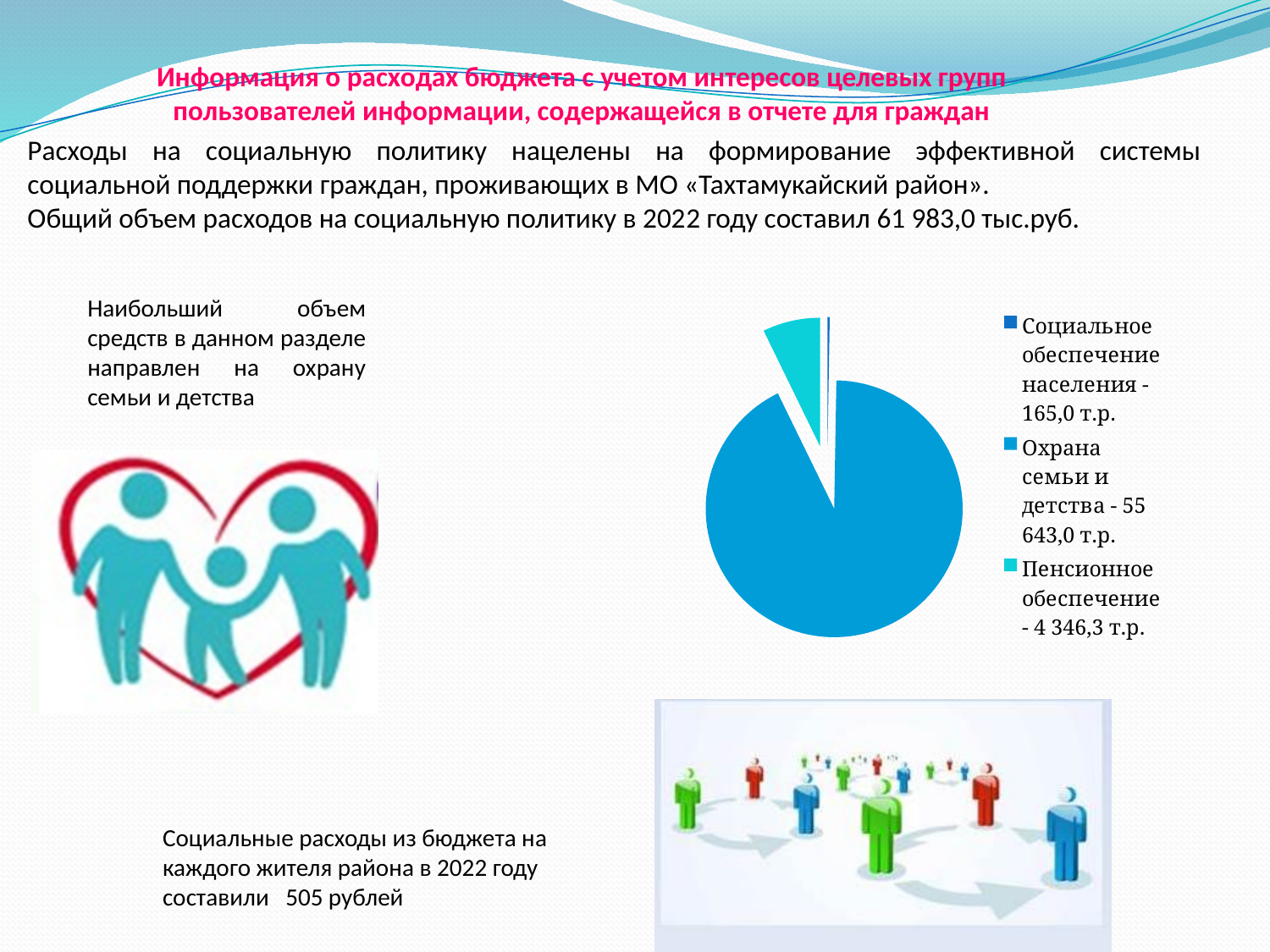
What value is given for Охрана семьи и детства in the pie chart legend? 55 643,0 т.р. How many slices does the pie chart have? 3 What value is given for Социальное обеспечение населения in the pie chart legend? 165,0 т.р. What kind of chart is shown on the slide? Pie chart Which category has the smallest slice in the pie chart? Социальное обеспечение населения What is the difference between Охрана семьи и детства and Пенсионное обеспечение in the pie chart? 51 296,7 т.р. What is the difference between Пенсионное обеспечение and Социальное обеспечение населения in the pie chart? 4 181,3 т.р. Which legend entry of the pie chart is shown in light turquoise? Пенсионное обеспечение Which is larger in the pie chart: Пенсионное обеспечение or Социальное обеспечение населения? Пенсионное обеспечение How many entries does the legend of the pie chart list? 3 What value is given for Пенсионное обеспечение in the pie chart legend? 4 346,3 т.р. Which category has the largest slice in the pie chart? Охрана семьи и детства